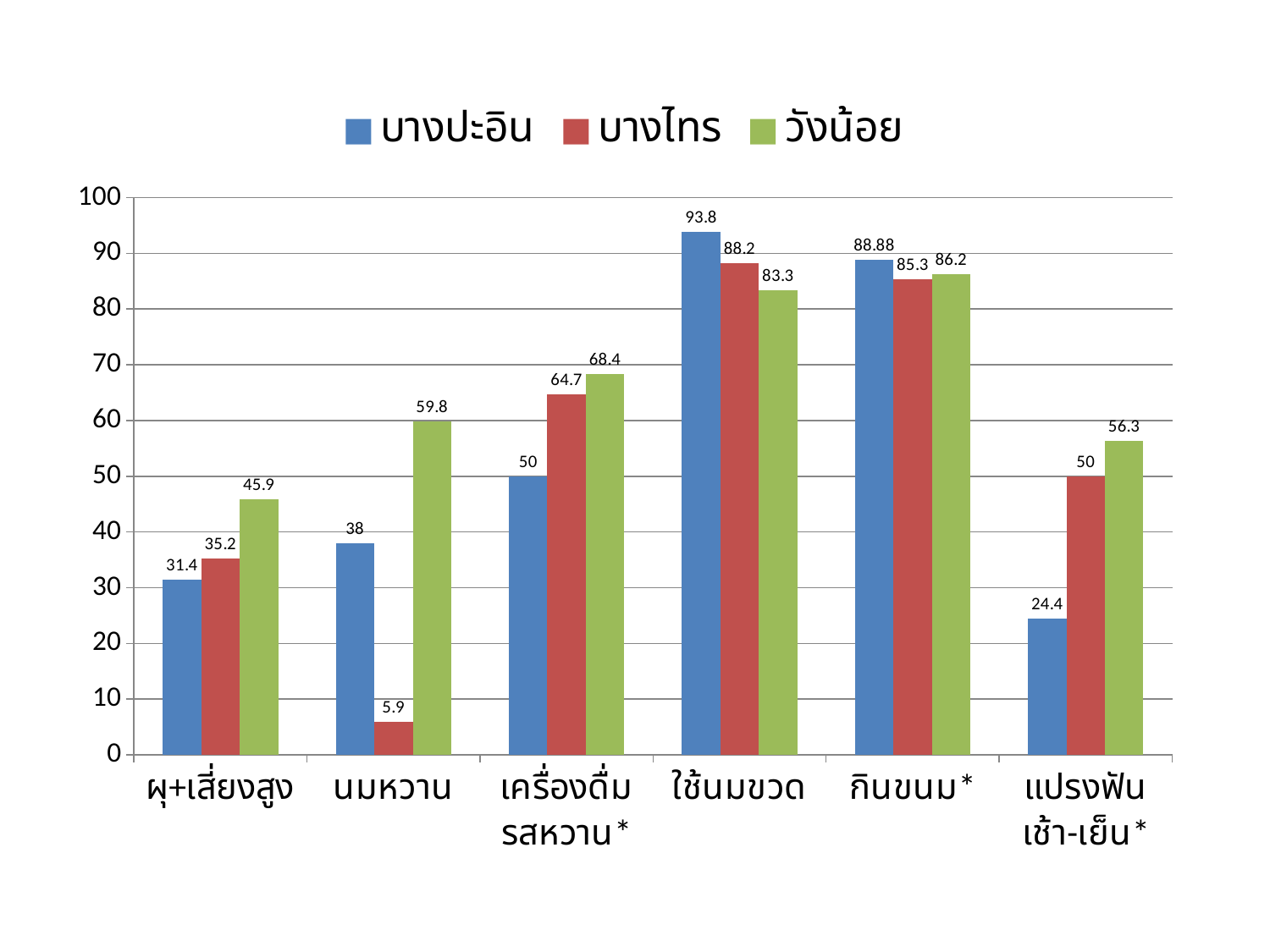
Which colour represents the บางไทร series? Red Which category has the highest value for วังน้อย? กินขนม* What kind of chart is shown on the slide? Bar chart What is the value for บางปะอิน in the ใช้นมขวด category? 93.8 What is the value for บางไทร in the นมหวาน category? 5.9 Which category has the lowest value for บางไทร? นมหวาน What is the value for วังน้อย in the แปรงฟันเช้า-เย็น* category? 56.3 What is the value for บางปะอิน in the กินขนม* category? 88.88 What is the difference between the วังน้อย and บางปะอิน values in the นมหวาน category? 21.8 How many categories are shown on the x axis? 6 In the ใช้นมขวด category, which series has the larger value, บางปะอิน or วังน้อย? บางปะอิน How many series does the legend list? 3